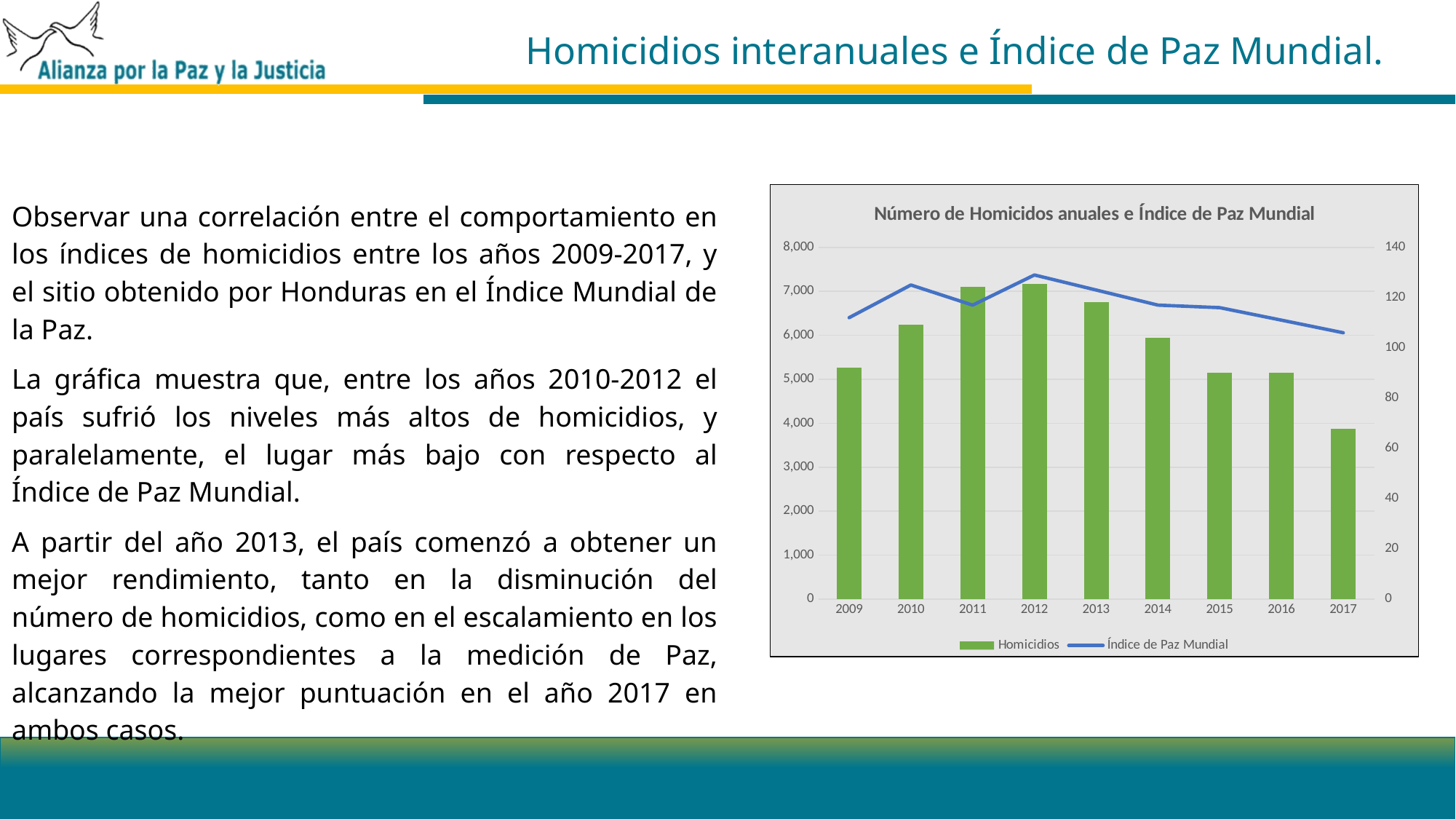
Is the Homicidios value for 2009 greater or less than 5,000? greater Is the Homicidios value for 2017 greater or less than 4,000? less Which year has more Homicidios, 2010 or 2017? 2010 Is the Índice de Paz Mundial value for 2017 greater or less than 120? less How many years are shown on the x axis of the chart? 9 What is the title of the chart? Número de Homicidos anuales e Índice de Paz Mundial How many series does the chart legend list? 2 Which year has the lowest number of Homicidios? 2017 What kind of chart is shown on the slide? Bar chart with a line Do the Homicidios values rise or fall from 2013 to 2017? fall